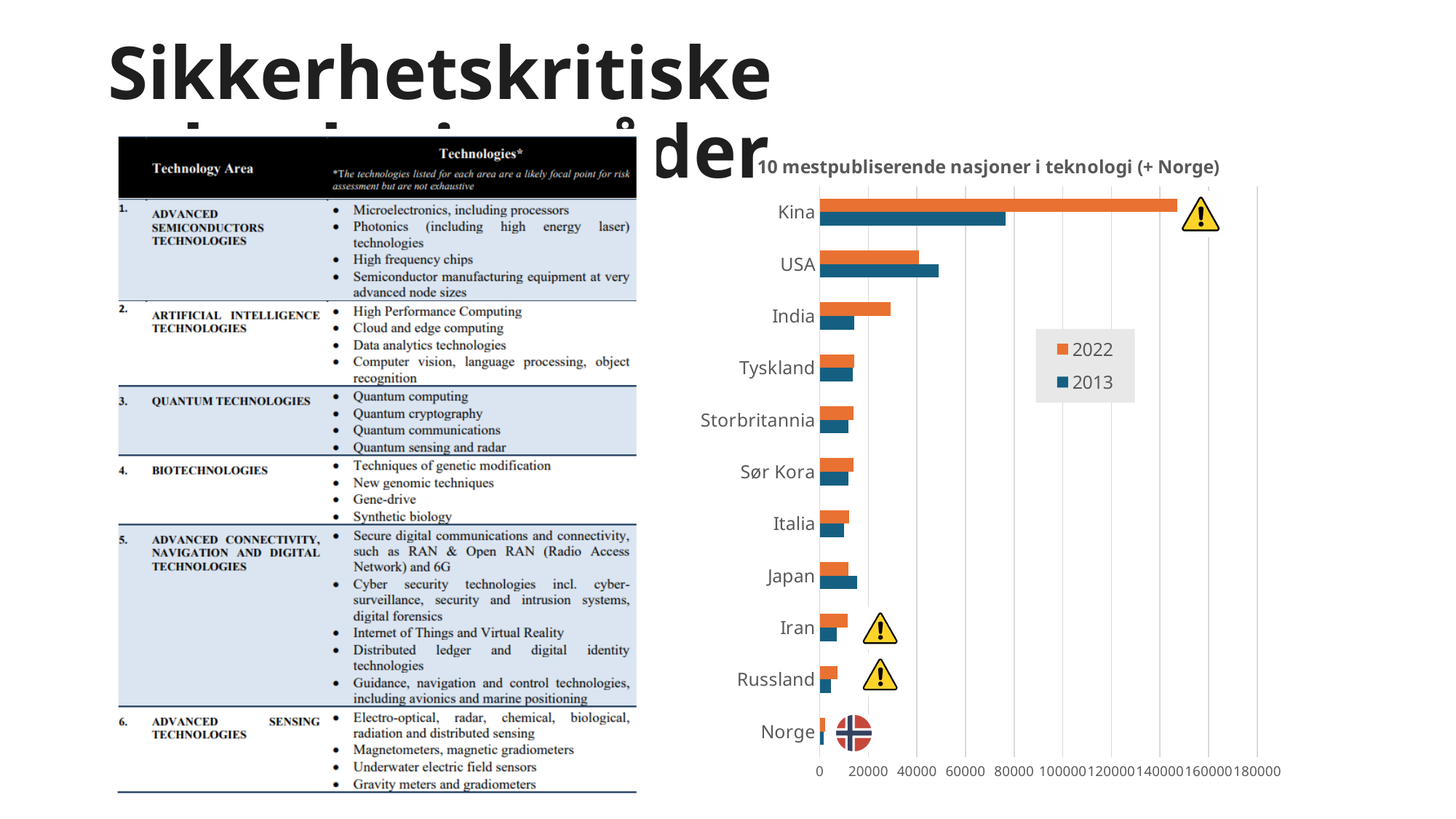
For USA, which series is larger, 2022 or 2013? 2013 What is the title of the chart? 10 mestpubliserende nasjoner i teknologi (+ Norge) How many countries are shown on the chart? 11 For Kina, which series is larger, 2022 or 2013? 2022 Is the 2022 value for Kina greater or less than 120000? greater Is the 2013 value for India greater or less than 20000? less How many series does the legend of the chart list? 2 For Japan, which series is larger, 2022 or 2013? 2013 Is the 2013 value for USA greater or less than 40000? greater Which country has the lowest value for 2022? Norge Which country has the highest value for 2022? Kina What kind of chart is shown on the slide? bar chart